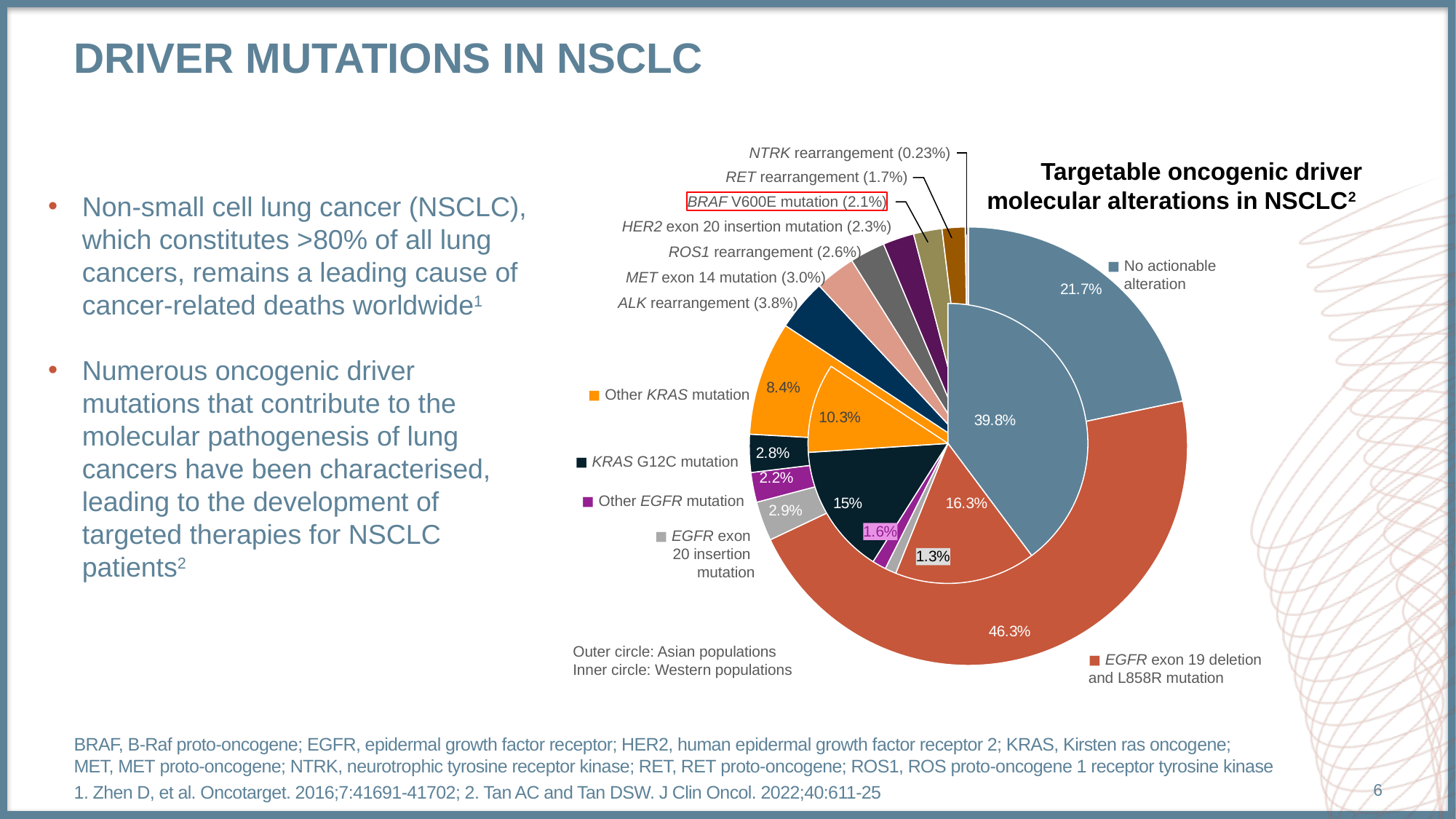
What percentage is given for NTRK rearrangement in the chart? 0.23% What is the title of the chart? Targetable oncogenic driver molecular alterations in NSCLC What percentage is shown for EGFR exon 19 deletion and L858R mutation in the outer circle (Asian populations)? 46.3% What percentage is given for ALK rearrangement in the chart? 3.8% What percentage is shown for KRAS G12C mutation in the inner circle (Western populations)? 15% According to the chart note, which population does the outer circle represent? Asian populations What is the difference between the No actionable alteration share in the inner circle (39.8%) and in the outer circle (21.7%)? 18.1% Which labelled category has the smallest share in the outer circle (Asian populations)? NTRK rearrangement Which is larger in the inner circle (Western populations): Other KRAS mutation or KRAS G12C mutation? KRAS G12C mutation What percentage is shown for No actionable alteration in the inner circle (Western populations)? 39.8% Which category has the largest share in the outer circle (Asian populations)? EGFR exon 19 deletion and L858R mutation What kind of chart is shown on the slide? Pie (doughnut) chart